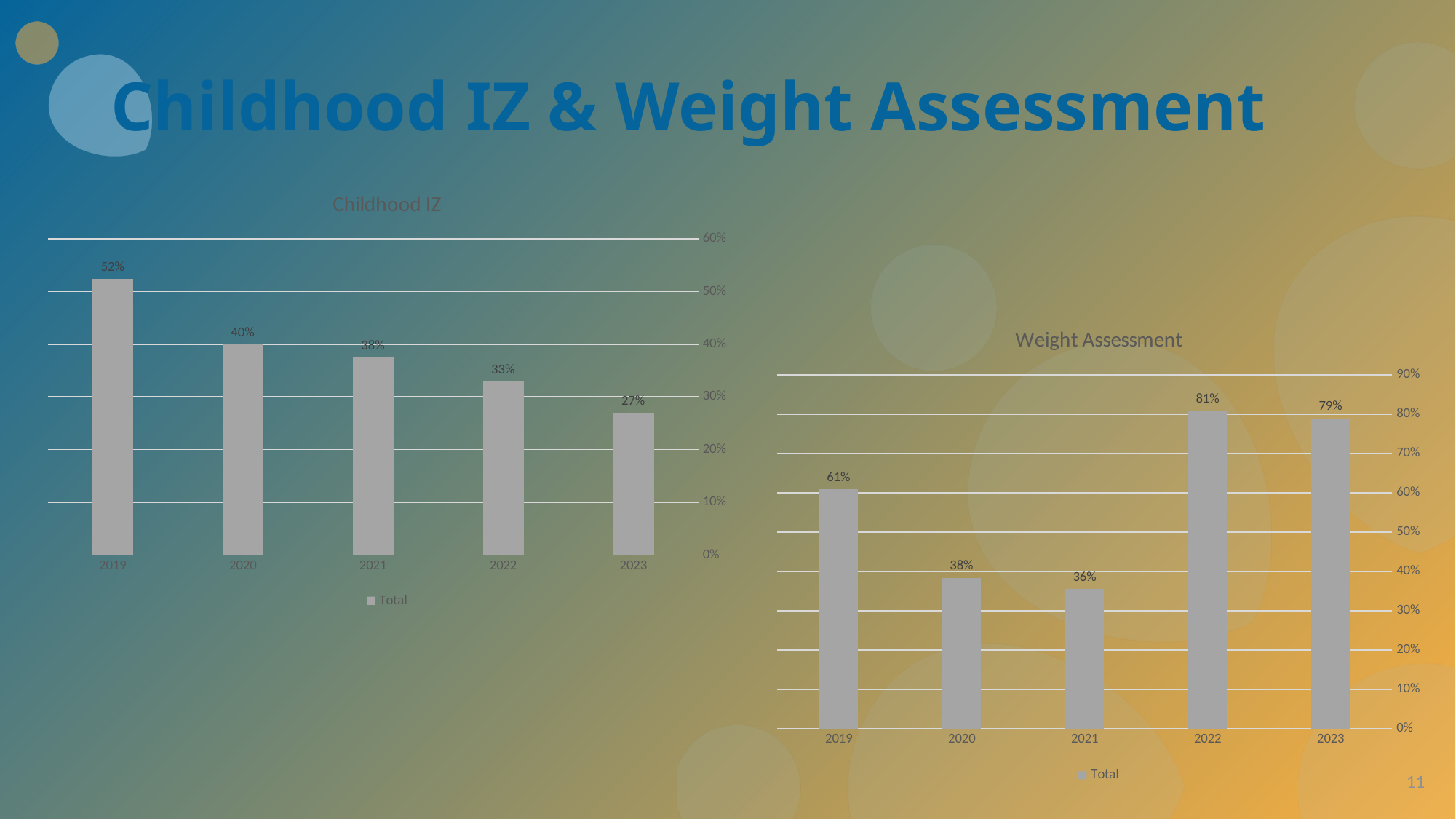
In the Childhood IZ chart, what is the value for 2023? 27% In the Childhood IZ chart, which year has the highest value? 2019 What kind of chart is the Childhood IZ chart? bar chart In the Weight Assessment chart, which is larger, the value for 2019 or the value for 2021? 2019 In the Weight Assessment chart, what is the difference between the 2022 and 2023 values? 2% In the Weight Assessment chart, what is the value for 2022? 81% In the Weight Assessment chart, which year has the lowest value? 2021 In the Childhood IZ chart, what is the value for 2019? 52% In the Childhood IZ chart, do the values rise or fall from 2019 to 2023? fall In the Childhood IZ chart, what is the difference between the 2019 and 2023 values? 25% In the Weight Assessment chart, what is the value for 2020? 38% How many years are shown on the x axis of the Weight Assessment chart? 5